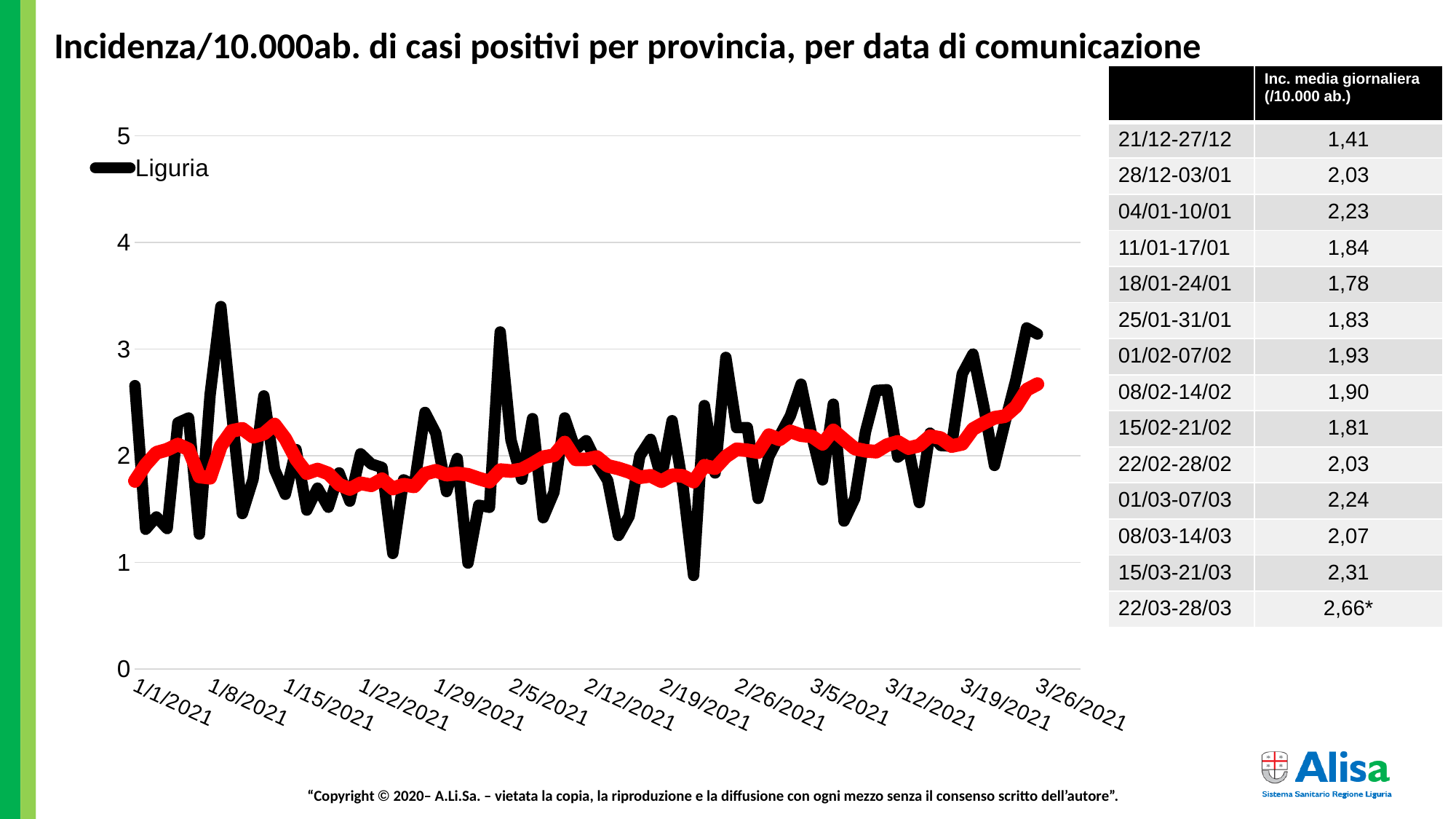
How many series does the chart legend list? 1 Is the value of the Liguria line at the last date, 3/26/2021, greater or less than 3? greater What is the name of the series shown in the chart legend? Liguria What is the title of the chart on the slide? Incidenza/10.000ab. di casi positivi per provincia, per data di comunicazione Is the peak of the Liguria line near 1/8/2021 greater or less than 3? greater Is the lowest point of the Liguria line, around 2/19/2021, greater or less than 1? less What kind of chart is shown on the slide? line chart What is the highest value shown on the y axis of the chart? 5 Does the red smoothed line rise or fall between 2/26/2021 and 3/26/2021? rise How many date labels are shown along the x axis of the chart? 13